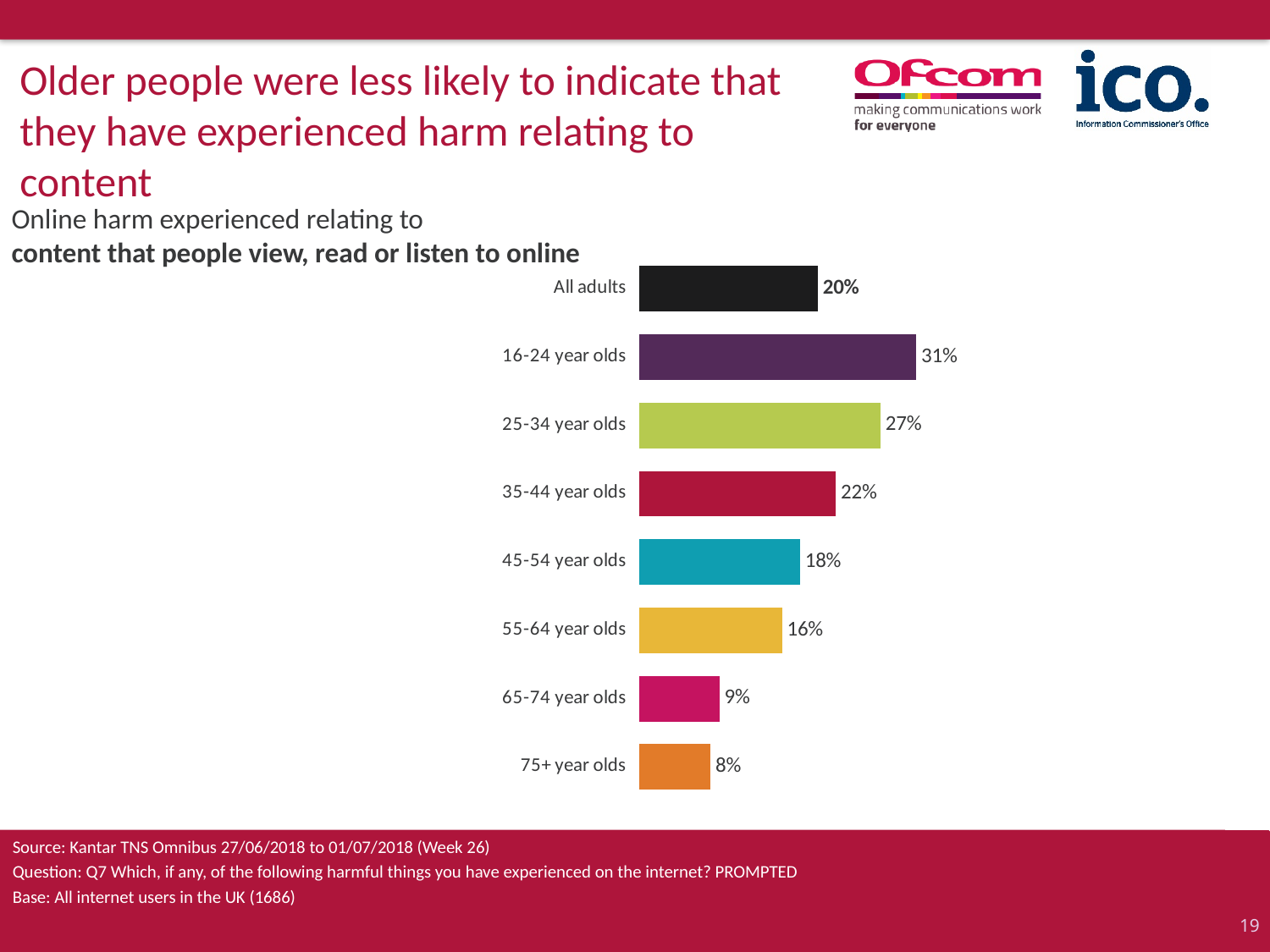
Which age group has the highest value? 16-24 year olds What is the value for 55-64 year olds? 16% What colour is the bar for All adults? Black What kind of chart is shown on the slide? Bar chart Which age group has the lowest value? 75+ year olds Do the values rise or fall as the age groups get older, from 16-24 year olds to 75+ year olds? Fall What is the value for 16-24 year olds? 31% How many categories are shown in the chart? 8 What percentage of all adults experienced online harm relating to content? 20% What is the difference between the values for 16-24 year olds and 75+ year olds? 23% Which is larger, the value for 45-54 year olds or the value for 65-74 year olds? 45-54 year olds What is the difference between the values for 25-34 year olds and 35-44 year olds? 5%